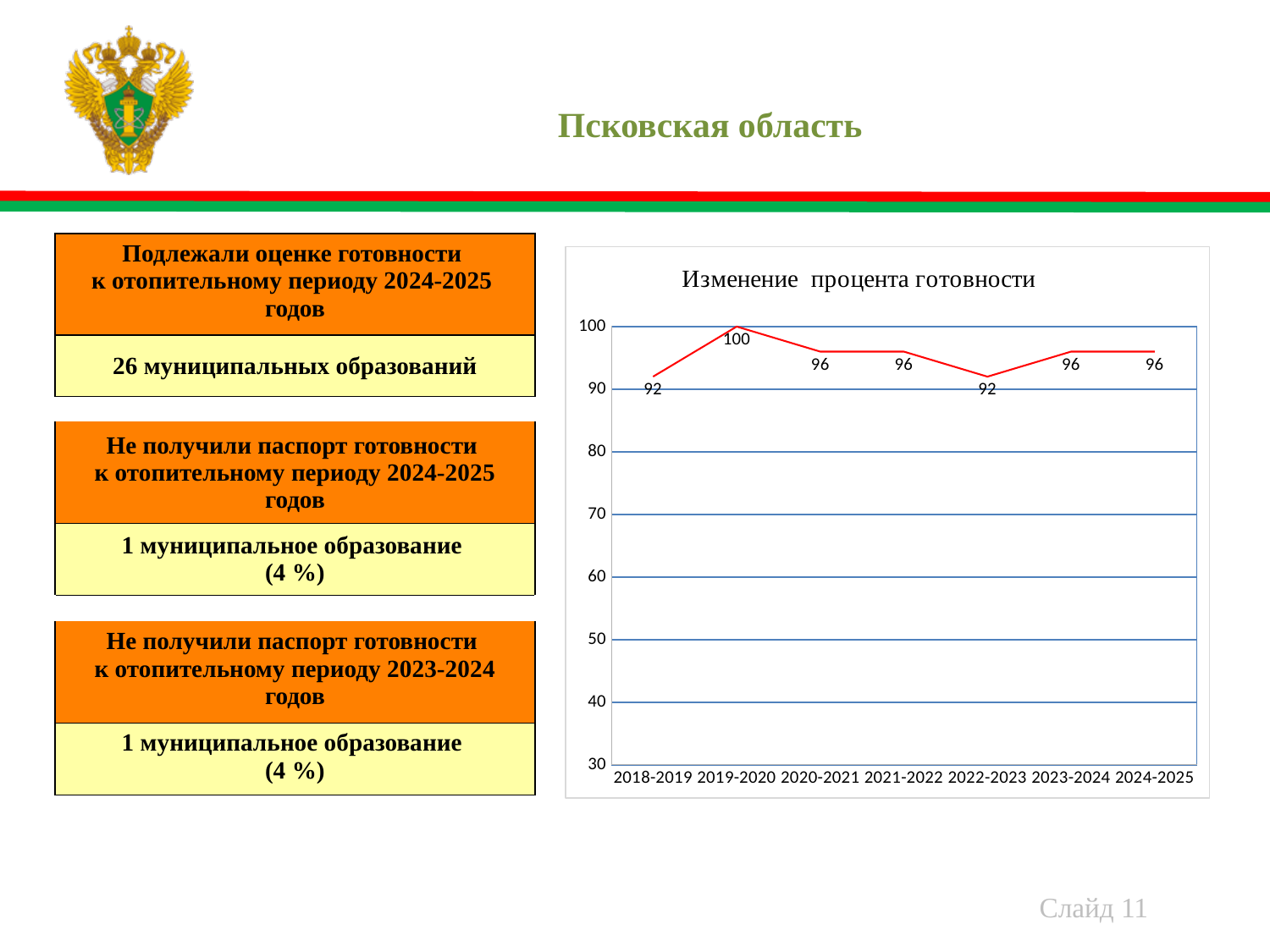
What is the value for 2018-2019 in the chart? 92 What is the difference between the values for 2019-2020 and 2022-2023? 8 What is the value for 2022-2023 in the chart? 92 Is the value for 2022-2023 greater or less than 90? greater What kind of chart is shown on the slide? line chart What is the value for 2019-2020 in the chart? 100 What is the title of the chart? Изменение процента готовности How many periods are shown on the x axis of the chart? 7 Which period has the highest value in the chart? 2019-2020 Which is larger, the value for 2019-2020 or the value for 2023-2024? 2019-2020 What is the value for 2024-2025 in the chart? 96 What is the difference between the values for 2020-2021 and 2018-2019? 4